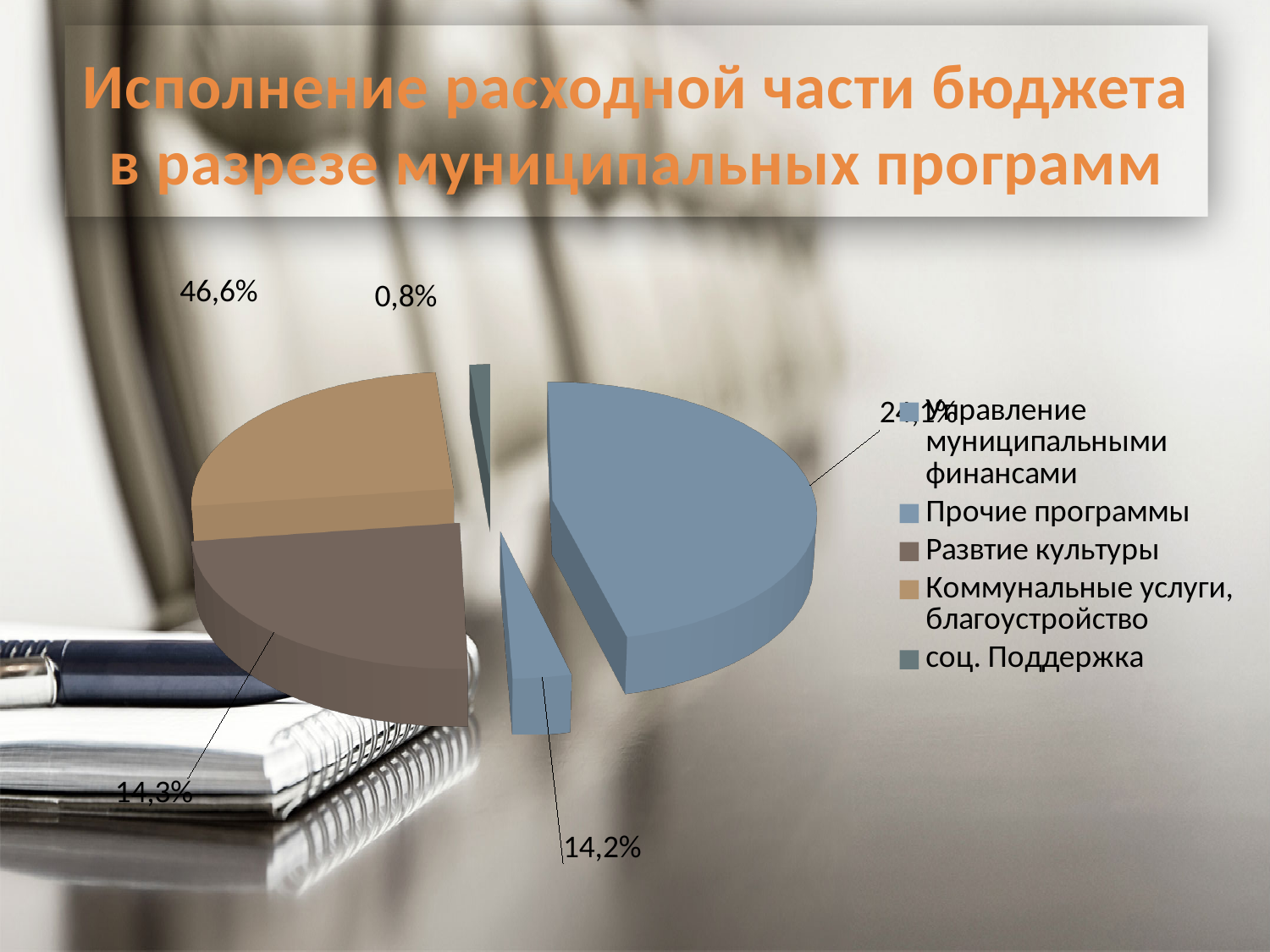
How many percentage data labels are printed on the pie chart? 5 What share of the pie is labelled for соц. Поддержка? 0,8% What is the largest percentage printed on the pie chart? 46,6% Which legend entry is listed last in the chart legend? соц. Поддержка What kind of chart is shown on the slide? pie chart What is the smallest percentage printed on the pie chart? 0,8% What percentage is shown for the Развтие культуры slice? 14,3% What is the title of the slide containing the pie chart? Исполнение расходной части бюджета в разрезе муниципальных программ How many entries does the chart legend list? 5 What is the difference between the 14,3% label and the 14,2% label? 0,1% What is the difference between the 46,6% label and the 24,1% label? 22,5%